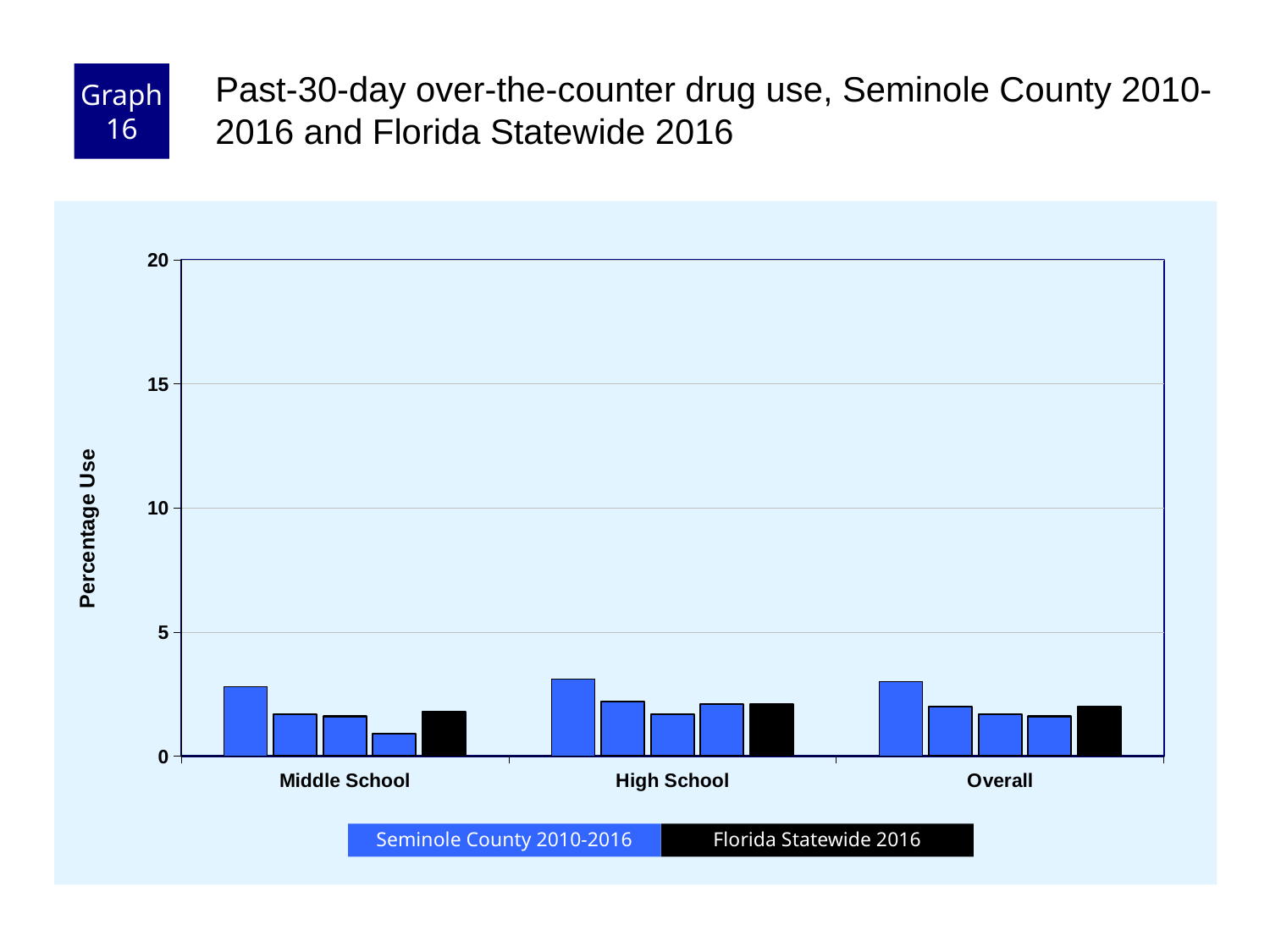
How many categories are shown along the x axis? 3 In the High School group, which bar is the highest? The first (leftmost) Seminole County bar In the Middle School group, which bar is the lowest? The fourth (rightmost) Seminole County bar Which colour represents Florida Statewide 2016 in the legend? Black How many series does the legend list? 2 Is the Florida Statewide 2016 value for High School greater or less than 5? less In the Middle School group, which is larger: the fourth (rightmost) Seminole County bar or the Florida Statewide 2016 bar? The Florida Statewide 2016 bar What is the label on the y axis? Percentage Use In the Middle School group, which is larger: the first (leftmost) Seminole County bar or the Florida Statewide 2016 bar? The first Seminole County bar What kind of chart is shown on the slide? Bar chart Is the Florida Statewide 2016 value for Overall greater or less than 5? less Are any of the bars on the chart greater than 10? No